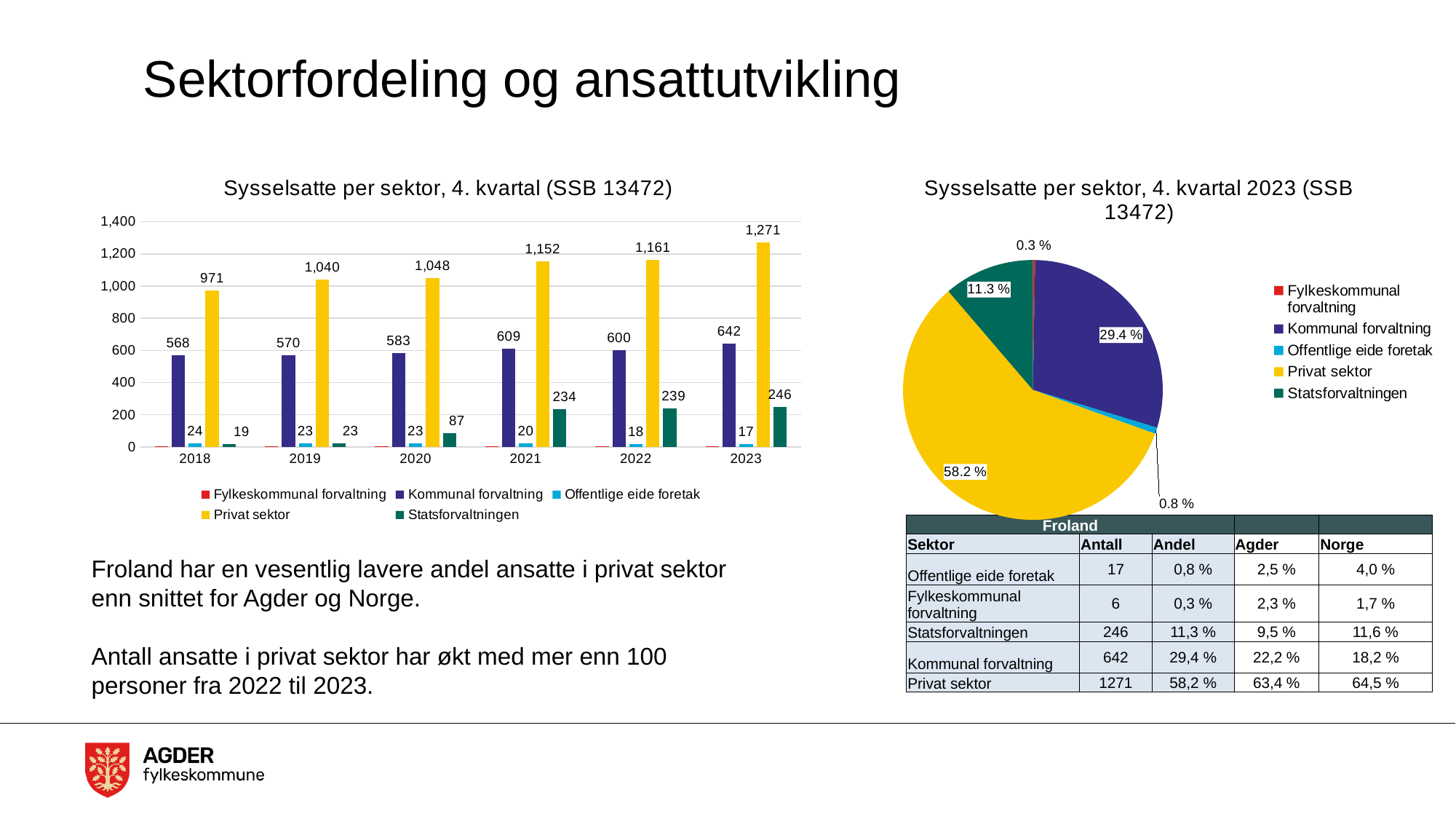
In the bar chart 'Sysselsatte per sektor, 4. kvartal (SSB 13472)', what is the difference between the Privat sektor values for 2023 and 2022? 110 In the bar chart 'Sysselsatte per sektor, 4. kvartal (SSB 13472)', how many series does the legend list? 5 What kind of chart is the chart on the right of the slide? pie chart In the bar chart 'Sysselsatte per sektor, 4. kvartal (SSB 13472)', which year has the lowest value for Statsforvaltningen? 2018 In the bar chart 'Sysselsatte per sektor, 4. kvartal (SSB 13472)', how many years are shown on the x axis? 6 In the bar chart 'Sysselsatte per sektor, 4. kvartal (SSB 13472)', which year has the highest value for Privat sektor? 2023 In the bar chart 'Sysselsatte per sektor, 4. kvartal (SSB 13472)', what is the value for Statsforvaltningen in 2020? 87 In the bar chart 'Sysselsatte per sektor, 4. kvartal (SSB 13472)', is the value for Kommunal forvaltning in 2021 greater or less than 600? greater In the pie chart 'Sysselsatte per sektor, 4. kvartal 2023 (SSB 13472)', what share does Privat sektor have? 58.2 % In the bar chart 'Sysselsatte per sektor, 4. kvartal (SSB 13472)', what is the value for Privat sektor in 2023? 1,271 In the bar chart 'Sysselsatte per sektor, 4. kvartal (SSB 13472)', do the values for Offentlige eide foretak rise or fall from 2018 to 2023? fall In the bar chart 'Sysselsatte per sektor, 4. kvartal (SSB 13472)', what is the value for Kommunal forvaltning in 2018? 568